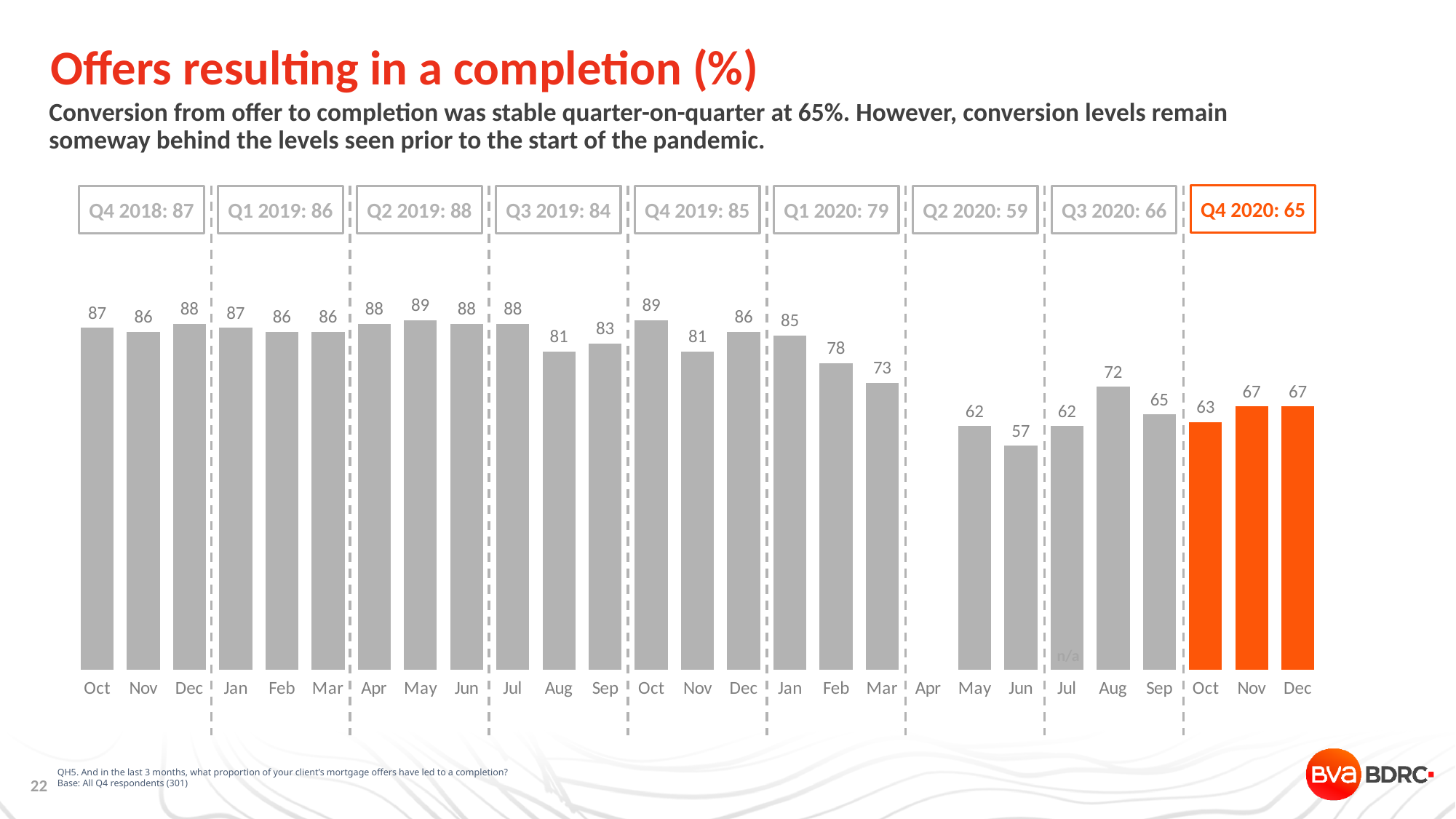
What is the difference between the values for Oct 2019 and Oct 2020? 26 What is the quarterly figure shown for Q2 2020? 59 What is the difference between the Q2 2019 and Q2 2020 quarterly figures? 29 What is the value for Jun 2020 on the chart? 57 Which month has the lowest value on the chart? Jun 2020 Which is larger, the value for Feb 2020 or the value for Sep 2020? Feb 2020 Which month shows no value (n/a) on the chart? Apr 2020 What is the value for Aug 2020 on the chart? 72 Do the values rise or fall from Jan 2020 to Mar 2020? Fall How many quarterly summary boxes are shown above the chart? 9 What type of chart is shown on the slide? Bar chart What is the value for Mar 2020 on the chart? 73